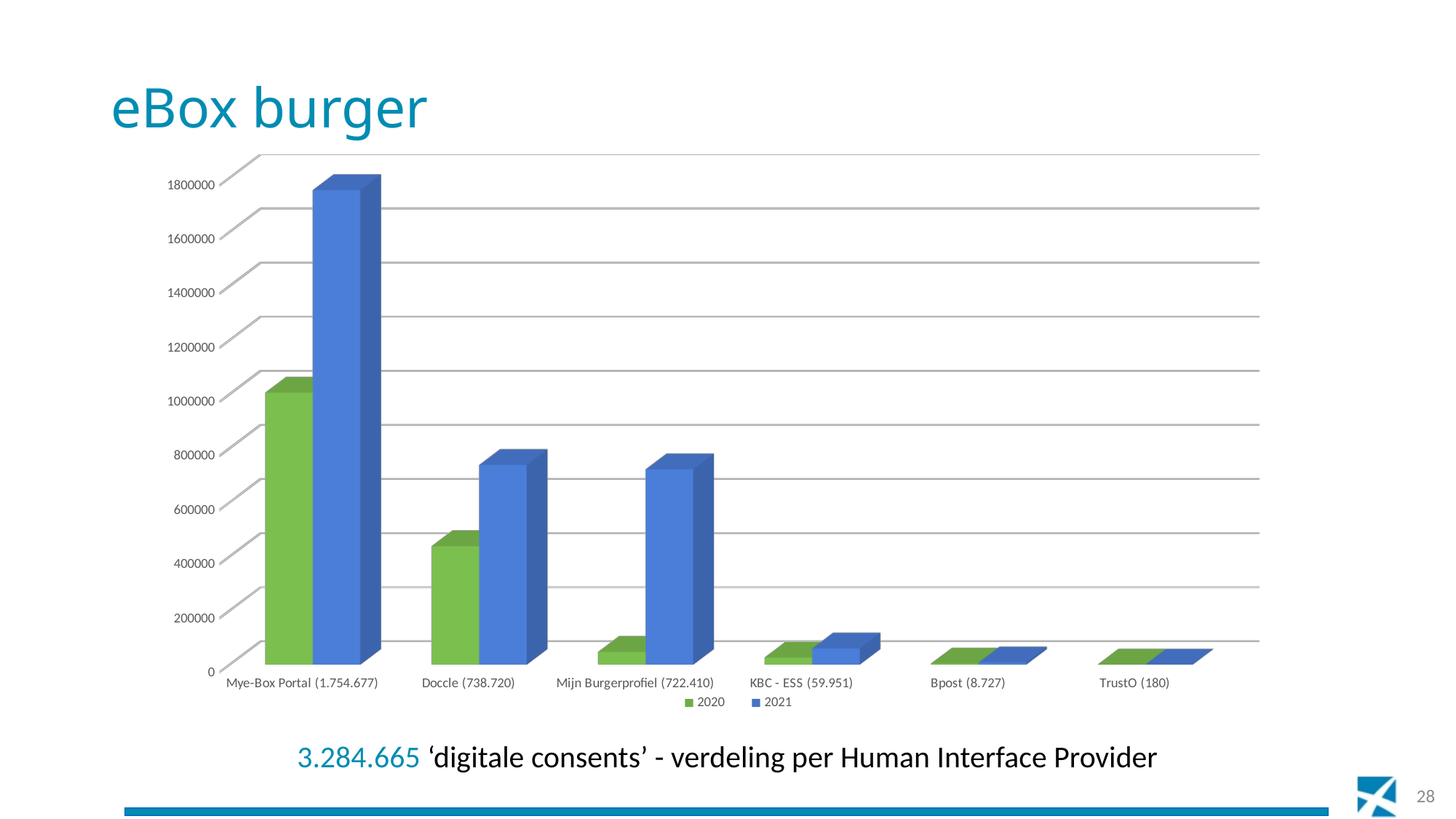
How many series does the legend list? 2 How many categories (Human Interface Providers) are shown on the x axis? 6 Is the 2021 value for Mijn Burgerprofiel greater or less than 600000? greater Which colour represents the 2021 series in the legend? blue Is the 2021 value for Mye-Box Portal greater or less than 1600000? greater Which category has the highest 2020 bar? Mye-Box Portal (1.754.677) Which category has the highest 2021 bar? Mye-Box Portal (1.754.677) For Doccle, which series has the larger value, 2020 or 2021? 2021 Is the 2020 value for Mijn Burgerprofiel greater or less than 200000? less Do the 2021 values rise or fall moving from left to right along the x axis? fall What kind of chart is shown on the slide? bar chart